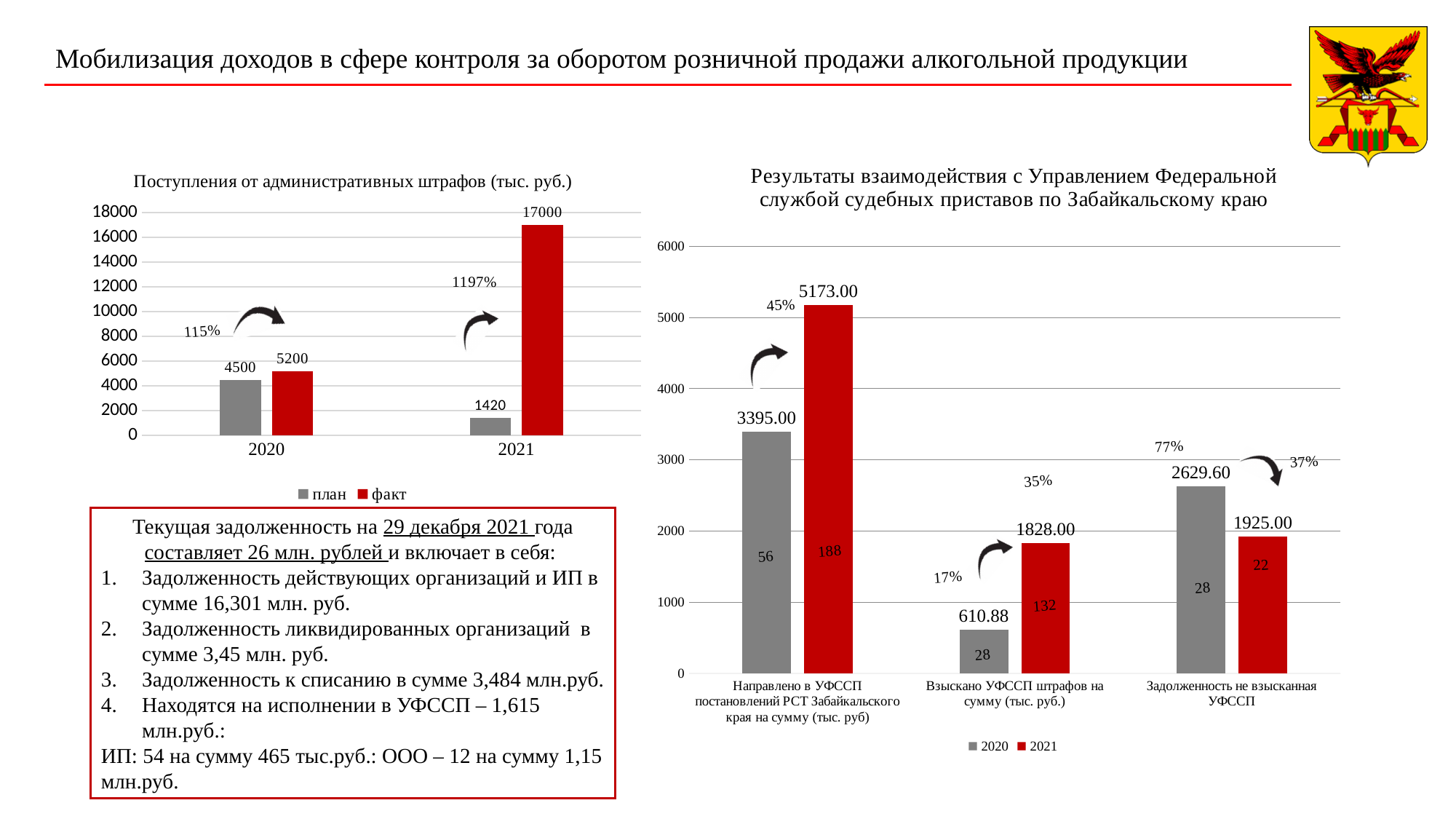
In the chart 'Поступления от административных штрафов (тыс. руб.)', how many series does the legend list? 2 In the chart 'Результаты взаимодействия с Управлением Федеральной службой судебных приставов по Забайкальскому краю', what is the 2021 value for 'Взыскано УФССП штрафов на сумму (тыс. руб.)'? 1828.00 In the chart 'Поступления от административных штрафов (тыс. руб.)', what is the 'план' value for 2020? 4500 In the chart 'Результаты взаимодействия с Управлением Федеральной службой судебных приставов по Забайкальскому краю', which category has the highest 2021 value? Направлено в УФССП постановлений РСТ Забайкальского края на сумму (тыс. руб) In the chart 'Поступления от административных штрафов (тыс. руб.)', which is larger for 2020: 'план' or 'факт'? факт In the chart 'Результаты взаимодействия с Управлением Федеральной службой судебных приставов по Забайкальскому краю', what is the 2020 value for 'Задолженность не взысканная УФССП'? 2629.60 In the chart 'Поступления от административных штрафов (тыс. руб.)', what is the difference between the 'факт' and 'план' values for 2021? 15580 In the chart 'Поступления от административных штрафов (тыс. руб.)', what is the 'факт' value for 2021? 17000 In the chart 'Результаты взаимодействия с Управлением Федеральной службой судебных приставов по Забайкальскому краю', how many categories are shown on the x axis? 3 In the chart 'Результаты взаимодействия с Управлением Федеральной службой судебных приставов по Забайкальскому краю', which category has the lowest 2020 value? Взыскано УФССП штрафов на сумму (тыс. руб.) What kind of chart is 'Поступления от административных штрафов (тыс. руб.)'? bar chart In the chart 'Результаты взаимодействия с Управлением Федеральной службой судебных приставов по Забайкальскому краю', what is the difference between the 2021 and 2020 values for 'Направлено в УФССП постановлений РСТ Забайкальского края на сумму (тыс. руб)'? 1778.00